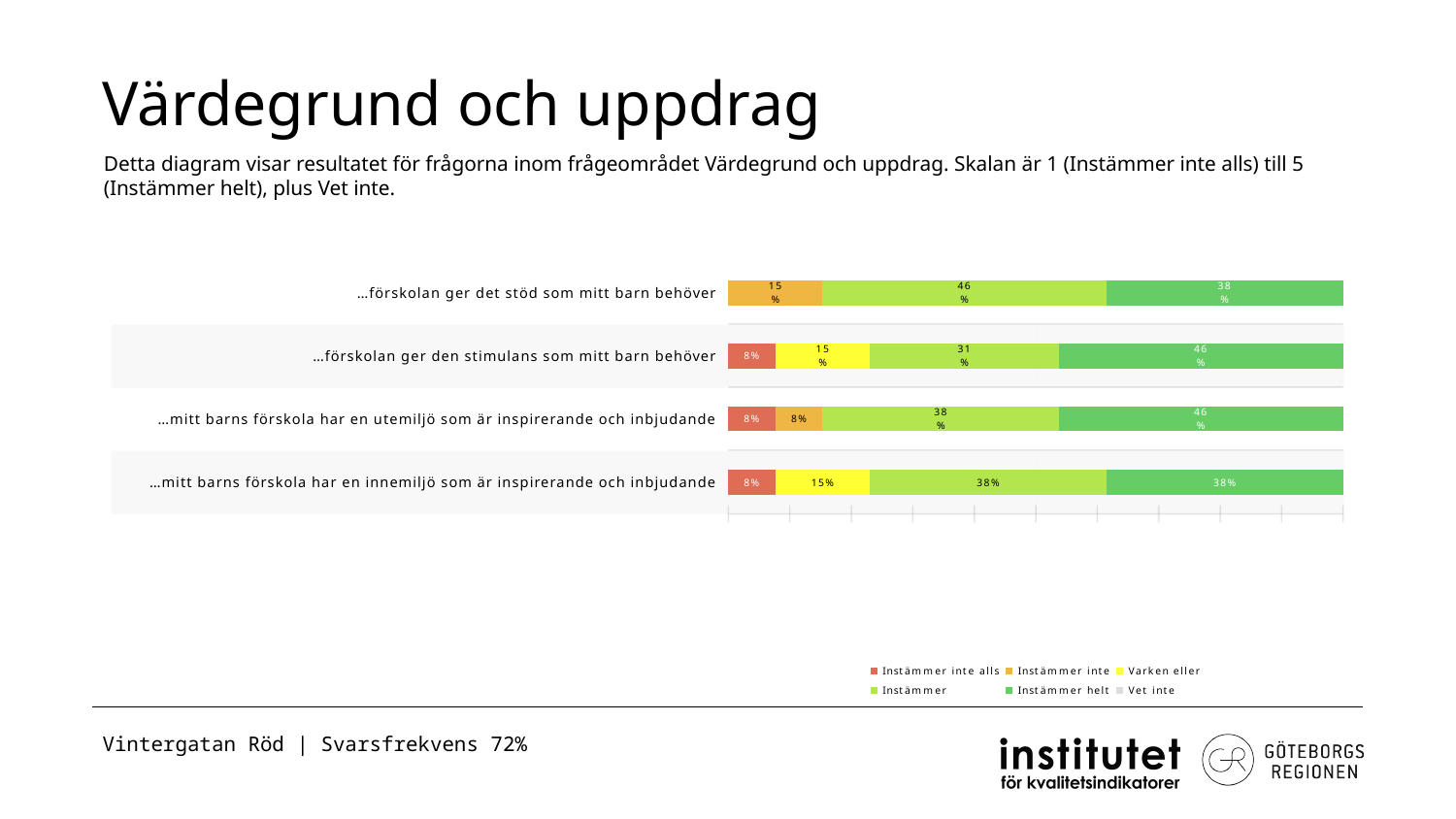
What is the difference between the 'Instämmer' and 'Instämmer helt' values for '…förskolan ger den stimulans som mitt barn behöver'? 15% What is the 'Varken eller' value for '…mitt barns förskola har en innemiljö som är inspirerande och inbjudande'? 15% What is the 'Instämmer inte alls' value for '…mitt barns förskola har en utemiljö som är inspirerande och inbjudande'? 8% How many categories (questions) are plotted in the chart? 4 What is the 'Instämmer helt' value for '…förskolan ger den stimulans som mitt barn behöver'? 46% What is the 'Instämmer inte' value for '…förskolan ger det stöd som mitt barn behöver'? 15% What kind of chart is shown on the slide? stacked bar chart How many series does the legend list? 6 What is the 'Instämmer' value for '…förskolan ger det stöd som mitt barn behöver'? 46% Which is larger for '…mitt barns förskola har en utemiljö som är inspirerande och inbjudande': the 'Instämmer' value or the 'Instämmer helt' value? Instämmer helt What is the title of the slide containing the chart? Värdegrund och uppdrag Which category has the highest 'Instämmer' value? …förskolan ger det stöd som mitt barn behöver